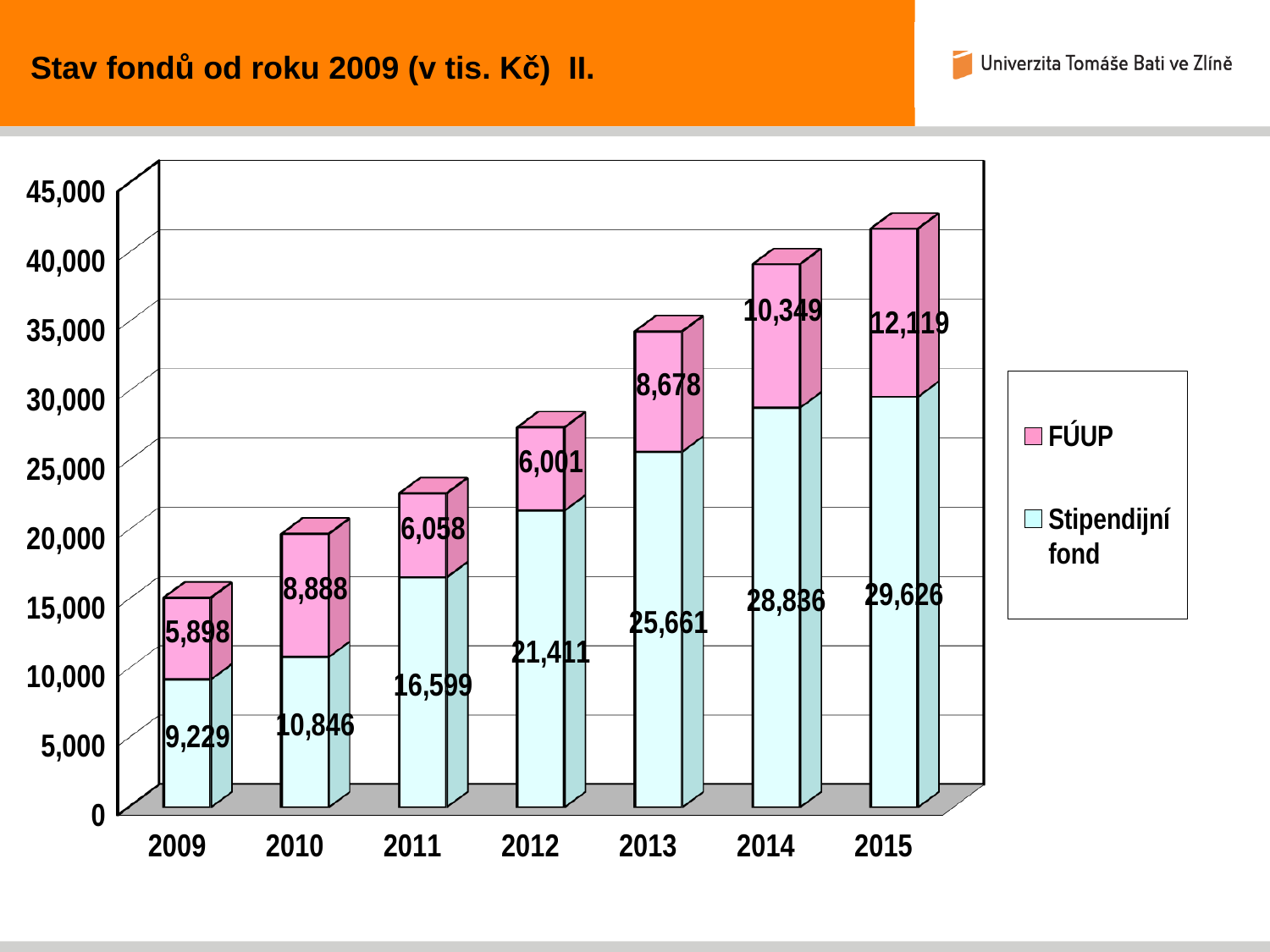
In which year is the Stipendijní fond value lowest? 2009 In which year is the FÚUP value highest? 2015 What is the total of the stacked bar for 2013? 34,339 How many years are shown on the x axis? 7 What kind of chart is shown on the slide? Stacked bar chart What is the value of Stipendijní fond in 2012? 21,411 Does the Stipendijní fond value rise or fall from 2009 to 2015? Rise How many series does the legend list? 2 What is the value of FÚUP in 2014? 10,349 What is the value of Stipendijní fond in 2009? 9,229 What is the difference between the Stipendijní fond values in 2015 and 2014? 790 Which is larger, the FÚUP value in 2010 or in 2011? 2010